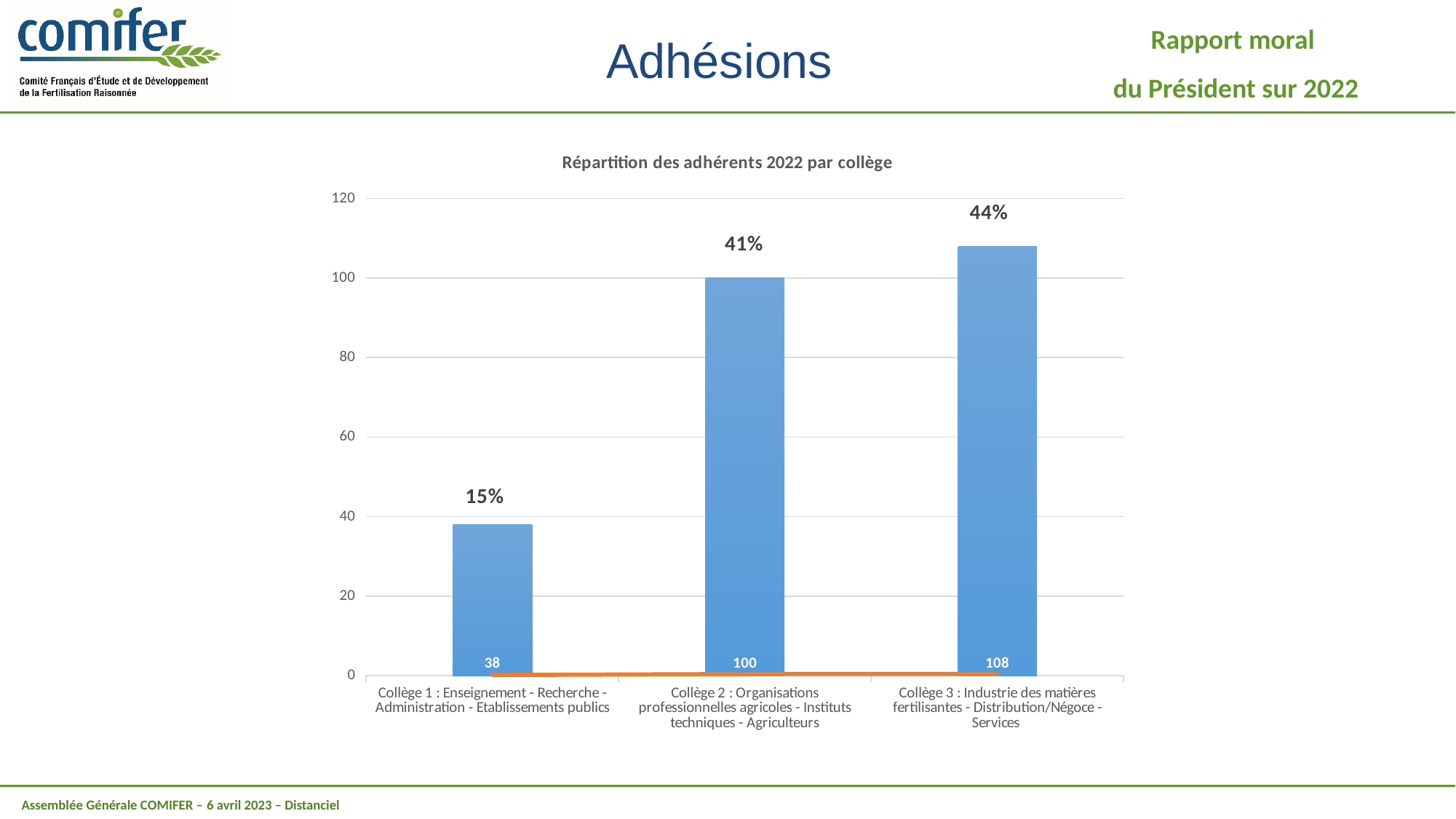
What is the number of members shown for Collège 3? 108 What is the difference in members between Collège 2 and Collège 1? 62 Which has more members, Collège 1 or Collège 2? Collège 2 What is the number of members shown for Collège 2? 100 Which collège has the lowest number of members? Collège 1 How many collèges (categories) are shown on the chart? 3 What percentage label is shown above the bar for Collège 1? 15% Which collège has the highest number of members? Collège 3 What is the difference in members between Collège 3 and Collège 2? 8 What percentage label is shown above the bar for Collège 3? 44% What is the title of the chart? Répartition des adhérents 2022 par collège What is the number of members shown for Collège 1? 38